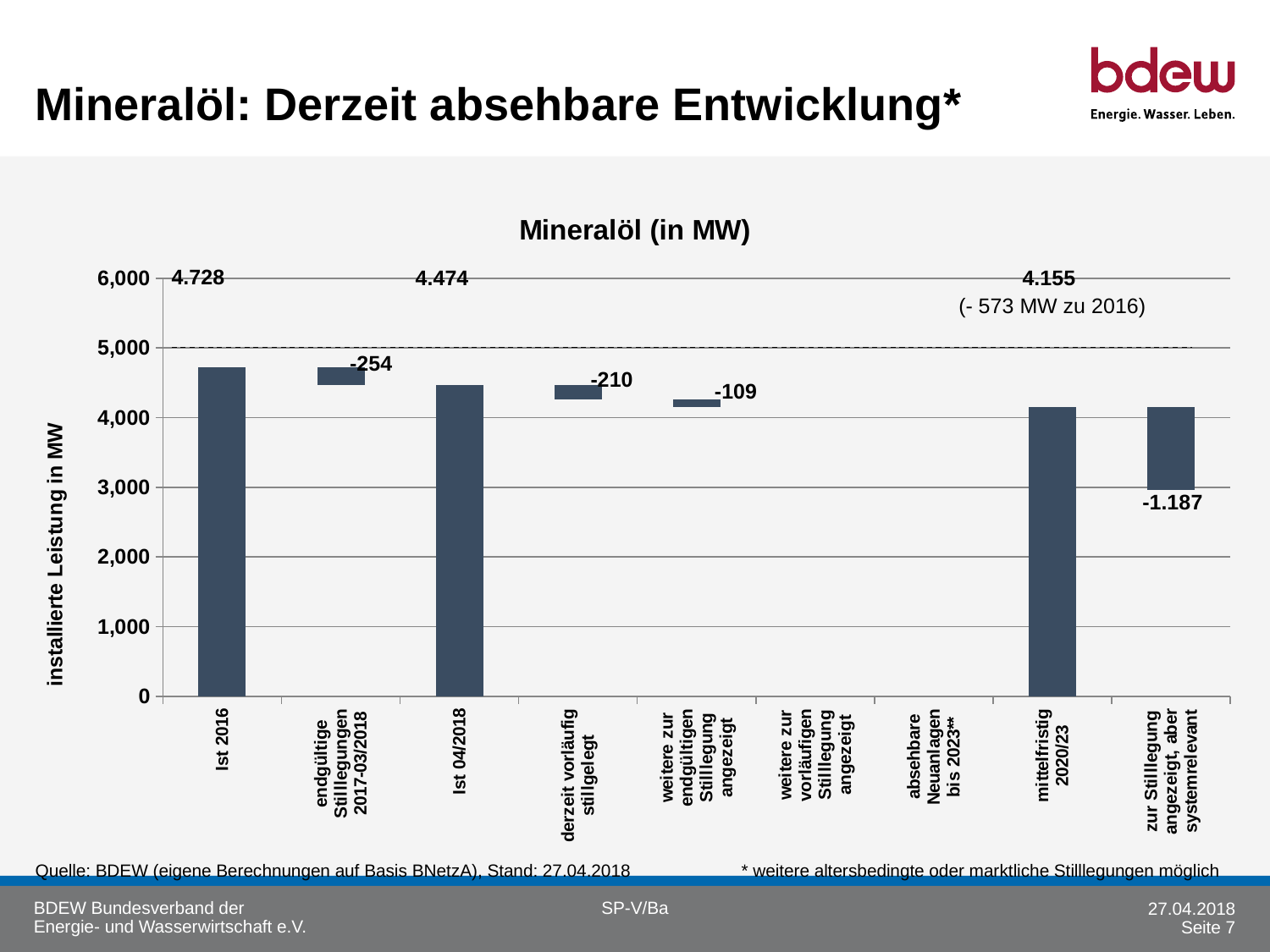
What is the value labelled for zur Stilllegung angezeigt, aber systemrelevant? -1.187 What is the value labelled for endgültige Stilllegungen 2017-03/2018? -254 What kind of chart is shown? bar chart Is the value for Ist 04/2018 greater or less than 4,000? greater What is the value for Ist 04/2018? 4.474 What is the value for mittelfristig 2020/23? 4.155 What is the value for Ist 2016? 4.728 What is the value labelled for derzeit vorläufig stillgelegt? -210 Which is larger, the value for Ist 2016 or the value for mittelfristig 2020/23? Ist 2016 Which category has the highest value? Ist 2016 How many categories are shown on the x axis? 9 What is the title of the chart? Mineralöl (in MW)